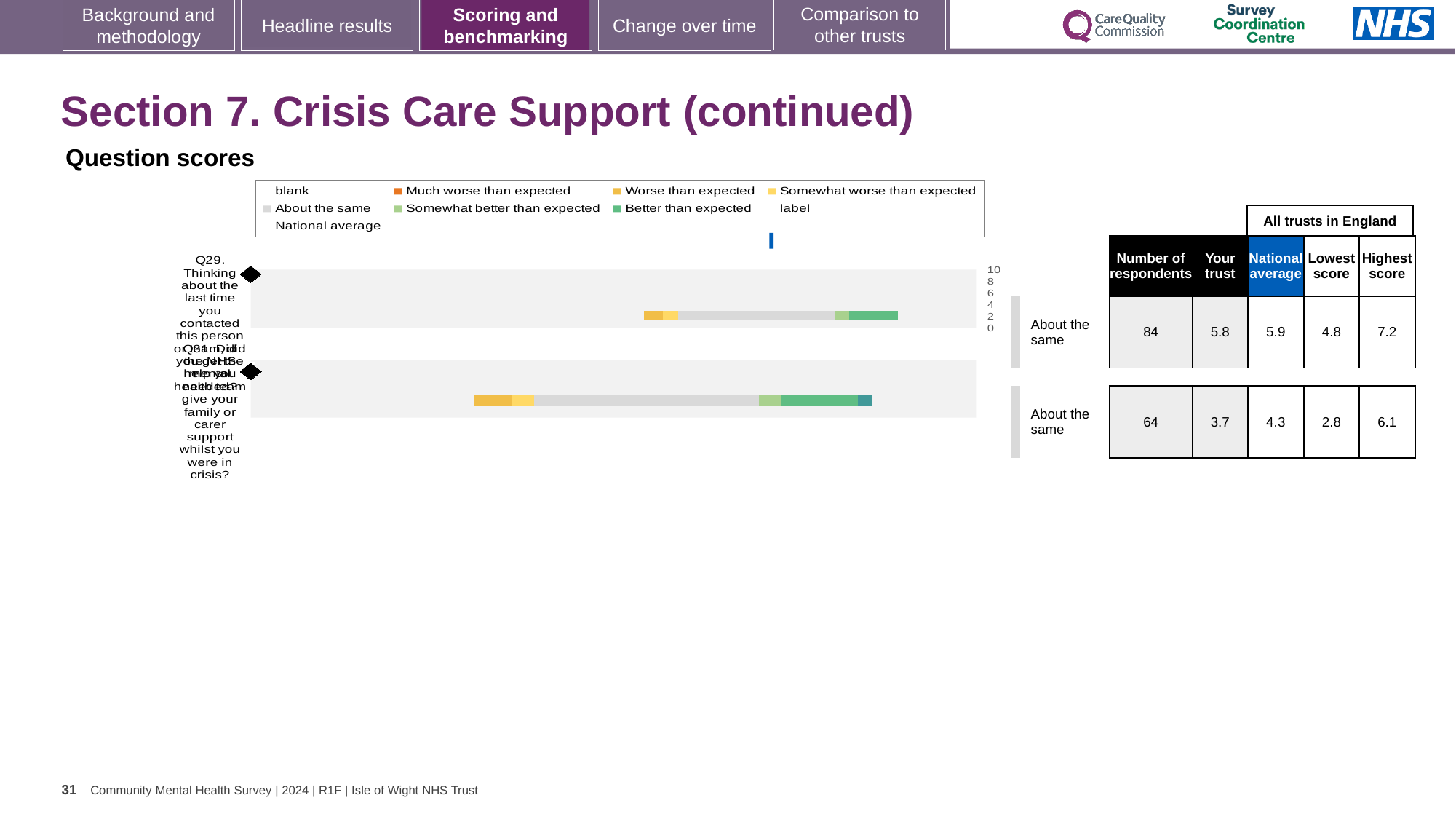
In the table beside the chart, what is the 'Your trust' score for Q31? 3.7 In the table beside the chart, what is the difference between the national average and the 'Your trust' score for Q31? 0.6 In the table beside the chart, what is the number of respondents for Q29? 84 In the table beside the chart, which is larger for Q31: the 'Your trust' score or the national average? National average In the table beside the chart, what is the national average for Q29? 5.9 In the table beside the chart, what is the highest score for Q31? 6.1 Which legend entry is shown in light grey? About the same What kind of chart is shown under 'Question scores'? bar chart What benchmark category is given for Q29 next to the chart? About the same How many question bars are plotted in the chart? 2 Which legend entry is shown in orange? Much worse than expected In the table beside the chart, what is the difference between the highest and lowest score for Q29? 2.4